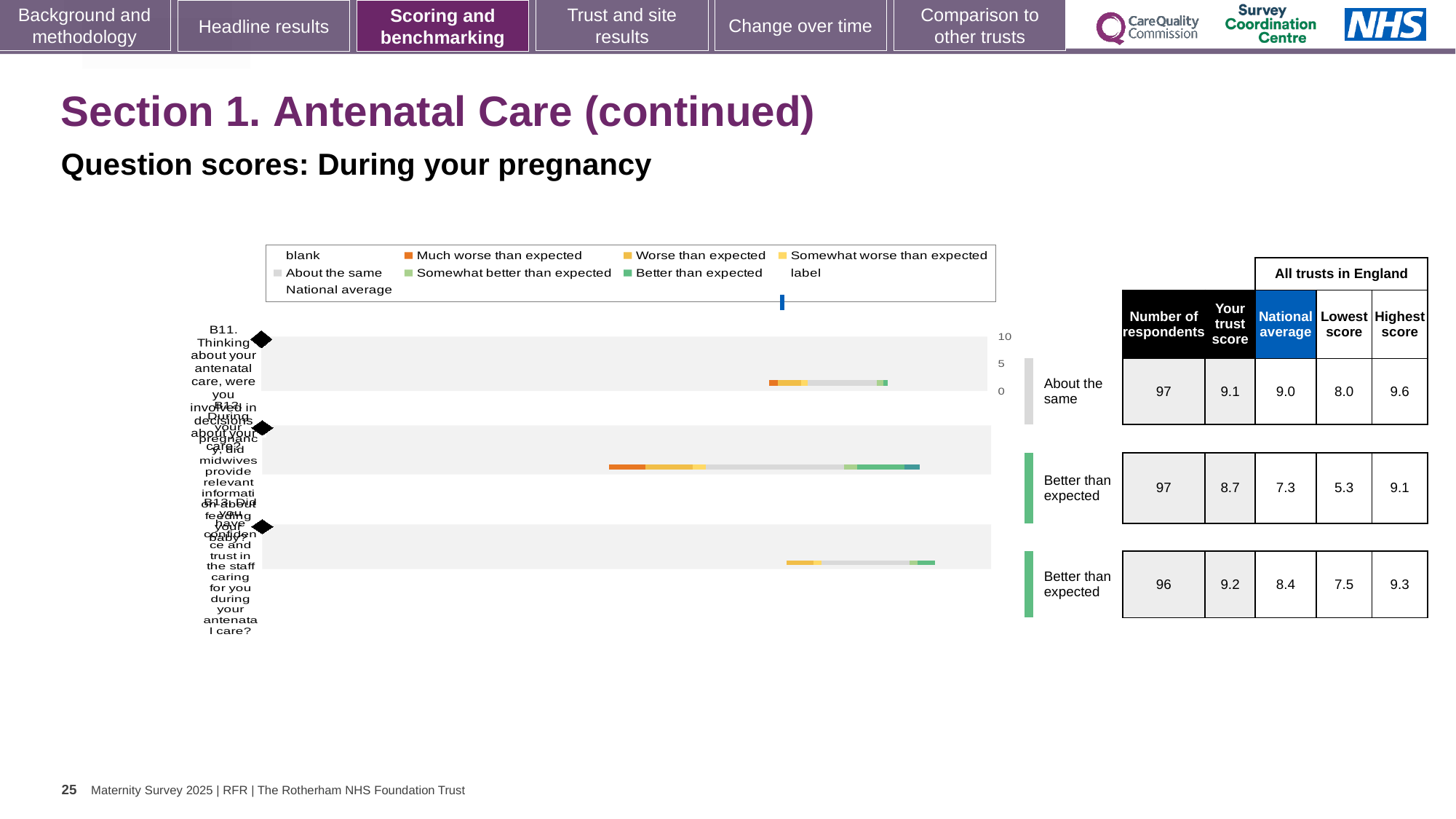
How many questions (rows) are plotted in the chart? 3 What is the trust score for question B11 (involved in decisions about your care)? 9.1 Is the trust score for question B11 larger or smaller than the national average for B11? larger What kind of chart is shown on the slide? bar chart What is the lowest score among all trusts in England for question B12? 5.3 What is the highest score among all trusts in England for question B13 (confidence and trust in staff during antenatal care)? 9.3 How many respondents answered question B13? 96 What is the difference between the trust score and the national average for question B12? 1.4 Which question has the lowest national average? B12 Which question has the highest trust score: B11, B12 or B13? B13 What is the national average for question B12 (midwives provide relevant information about feeding your baby)? 7.3 What benchmark category is shown for question B11? About the same